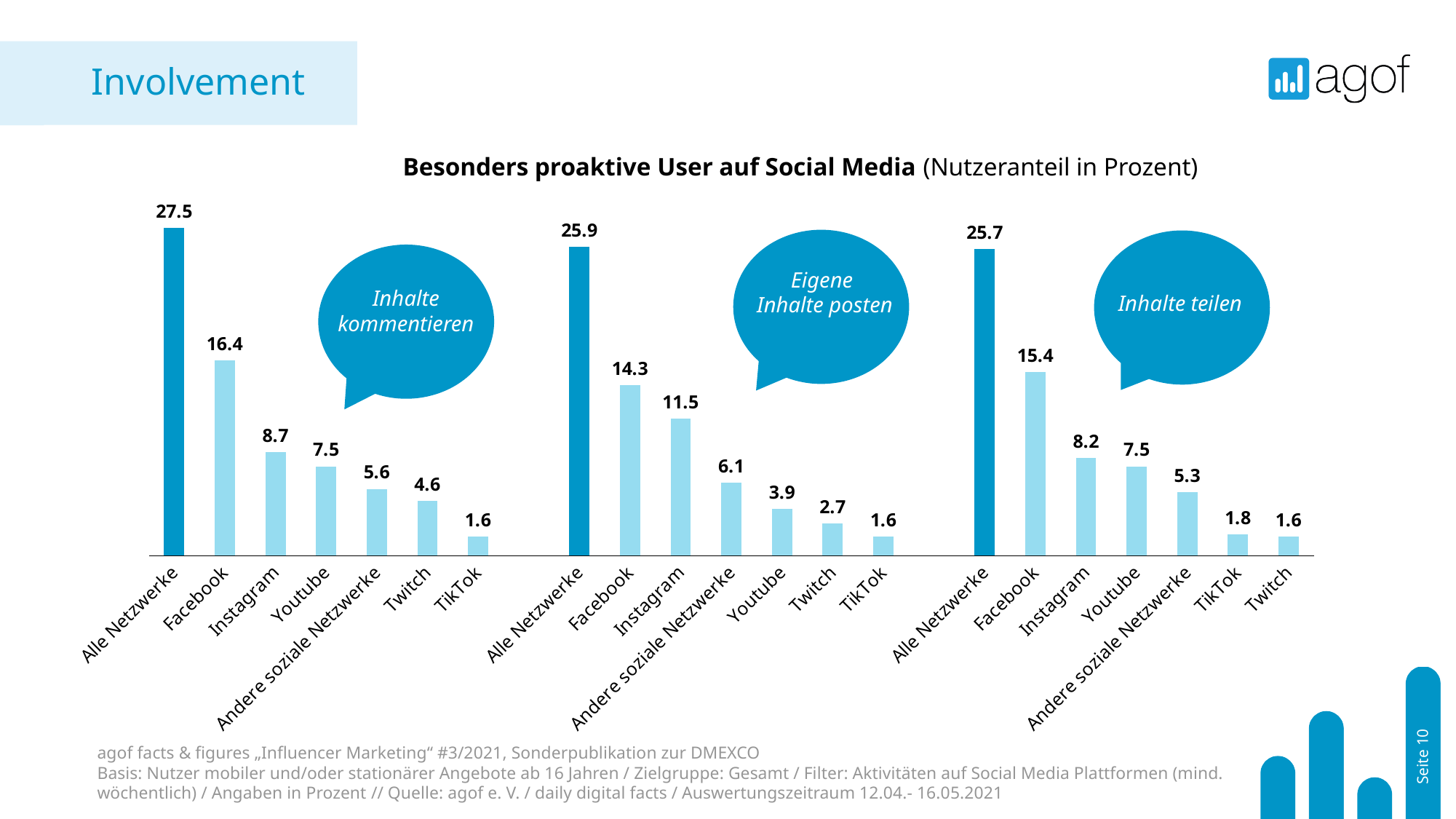
What kind of chart is shown on the slide? Bar chart In the "Eigene Inhalte posten" group, what is the value for Instagram? 11.5 What is the value for Alle Netzwerke in the "Eigene Inhalte posten" group? 25.9 What is the title of the chart? Besonders proaktive User auf Social Media (Nutzeranteil in Prozent) In the "Inhalte teilen" group, what is the value for Andere soziale Netzwerke? 5.3 Which is larger: Youtube in the "Inhalte kommentieren" group or Youtube in the "Eigene Inhalte posten" group? Inhalte kommentieren In the "Inhalte kommentieren" group, what is the value for Facebook? 16.4 What is the difference between Alle Netzwerke and Facebook in the "Inhalte teilen" group? 10.3 In the "Inhalte kommentieren" group, which category has the highest value? Alle Netzwerke In the "Eigene Inhalte posten" group, which category has the lowest value? TikTok How many categories are shown in each of the three groups? 7 In the "Inhalte teilen" group, do the values rise or fall from Alle Netzwerke to Twitch? Fall